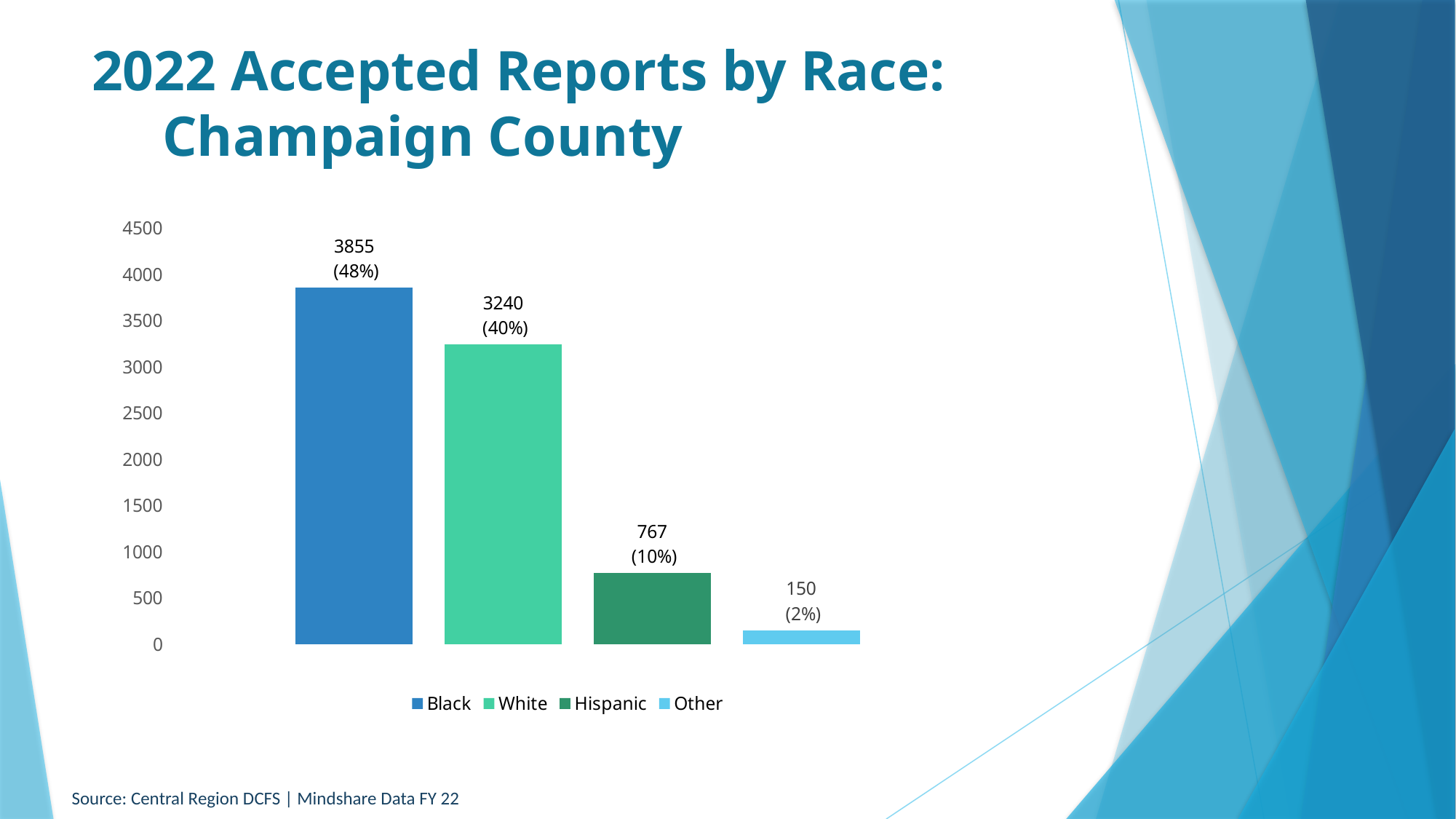
Which race category has the highest number of accepted reports? Black Which has more accepted reports, White or Hispanic? White How many accepted reports are shown for Hispanic? 767 What is the difference between the number of accepted reports for Hispanic and Other? 617 How many accepted reports are shown for Black? 3855 What kind of chart is shown on the slide? Bar chart What is the source cited at the bottom of the slide? Central Region DCFS | Mindshare Data FY 22 Which race category has the lowest number of accepted reports? Other How many accepted reports are shown for White? 3240 What is the difference between the number of accepted reports for Black and White? 615 What percentage of accepted reports is shown for Other? 2% How many race categories are shown in the chart? 4